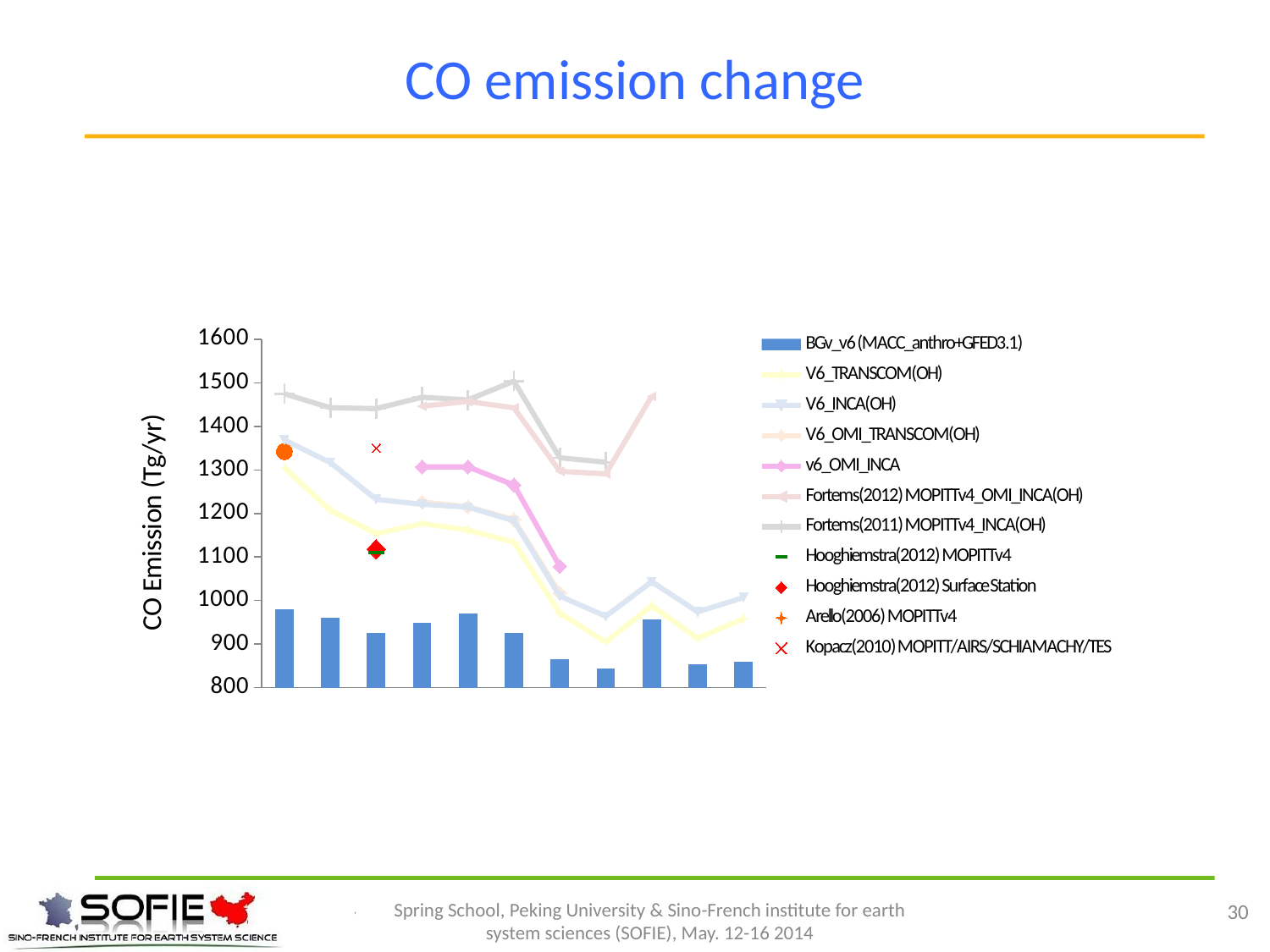
At the leftmost point, which is higher: Fortems(2011) MOPITTv4_INCA(OH) or V6_TRANSCOM(OH)? Fortems(2011) MOPITTv4_INCA(OH) Does the V6_TRANSCOM(OH) line start higher or lower than it ends? higher How many series does the legend list? 11 Is the Kopacz(2010) MOPITT/AIRS/SCHIAMACHY/TES value greater or less than 1300? greater Is the first (leftmost) BGv_v6 bar greater or less than 900? greater How many bars are plotted for the BGv_v6 (MACC_anthro+GFED3.1) series? 11 Is the Hooghiemstra(2012) Surface Station value greater or less than 1200? less What is the label of the vertical axis? CO Emission (Tg/yr) What kind of chart is shown on the slide? bar and line chart Which series is drawn as bars rather than as a line or marker? BGv_v6 (MACC_anthro+GFED3.1) Which series reaches the highest value on the chart? Fortems(2011) MOPITTv4_INCA(OH)